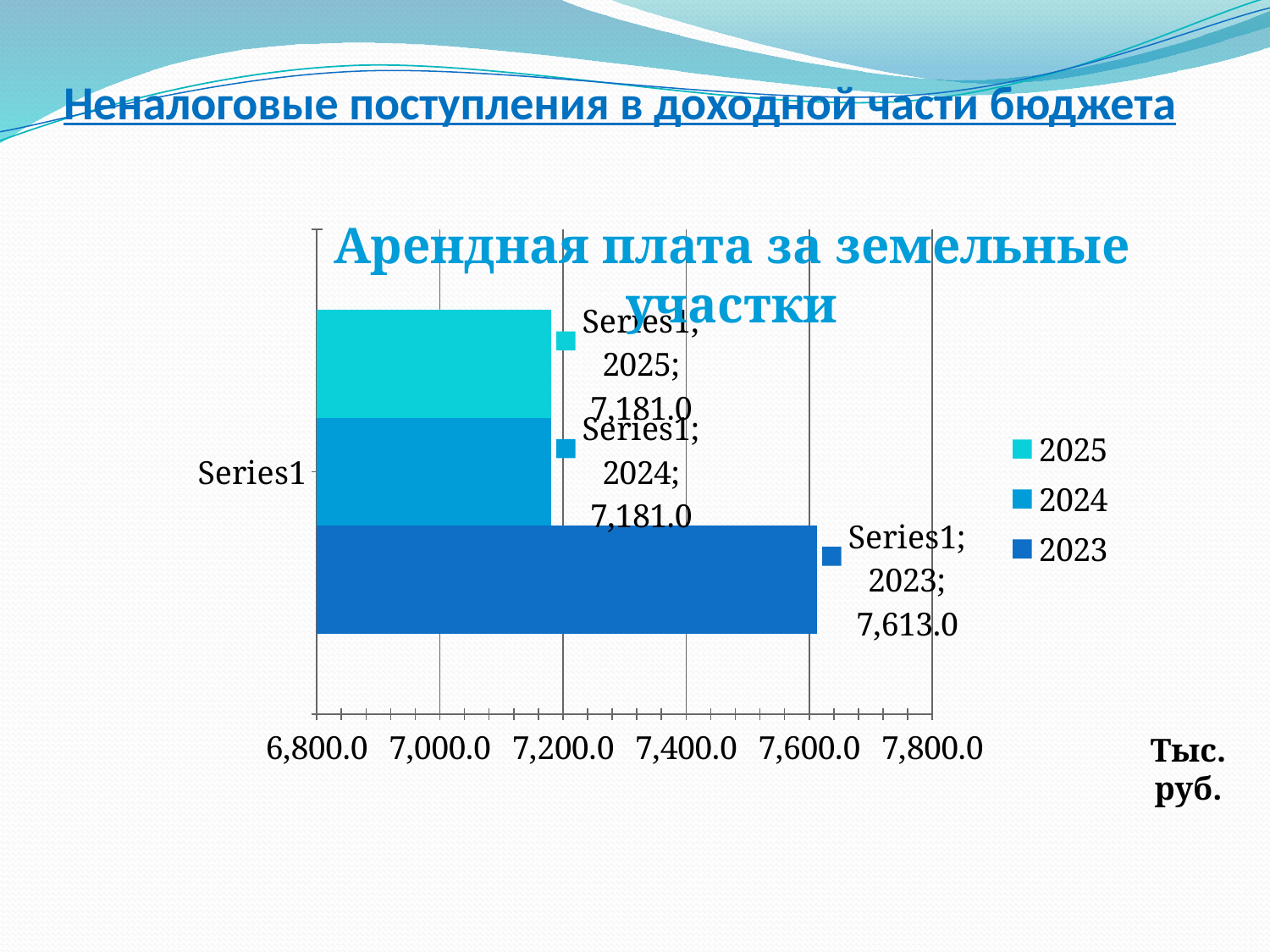
What is the value for 2023? 7,613.0 Which year has the highest value? 2023 Is the value for 2025 greater or less than 7,400.0? less What is the difference between the values for 2023 and 2024? 432.0 Is the value for 2023 greater or less than 7,400.0? greater What unit is indicated next to the chart's axis? Тыс. руб. What is the value for 2024? 7,181.0 What is the value for 2025? 7,181.0 How many series does the legend list? 3 Which is larger, the value for 2023 or the value for 2025? 2023 What is the title of the chart? Арендная плата за земельные участки What type of chart is shown on the slide? bar chart